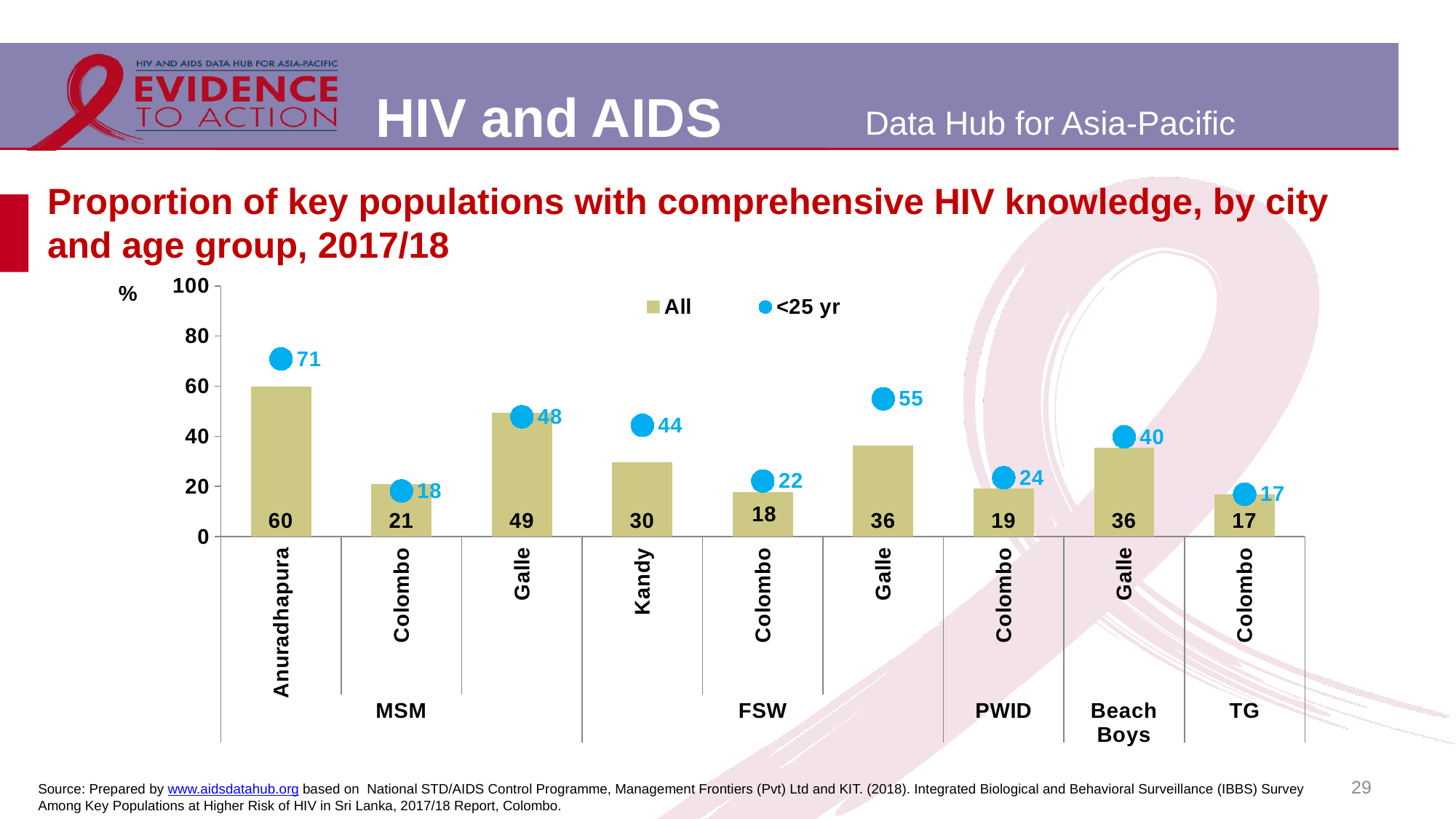
How many city/population categories are shown on the x axis? 9 What is the difference between the '<25 yr' value and the 'All' value for FSW in Kandy? 14 Which city and population group has the highest '<25 yr' value? Anuradhapura (MSM) What are the two series named in the legend? All and <25 yr Which city and population group has the lowest 'All' value? Colombo (TG) What is the '<25 yr' value for MSM in Colombo? 18 What is the 'All' value for Beach Boys in Galle? 36 How many series does the legend list? 2 What is the 'All' value for MSM in Anuradhapura? 60 Which is larger for PWID in Colombo: the 'All' value or the '<25 yr' value? <25 yr What is the '<25 yr' value for FSW in Galle? 55 What kind of chart is used to show the 'All' series? Bar chart